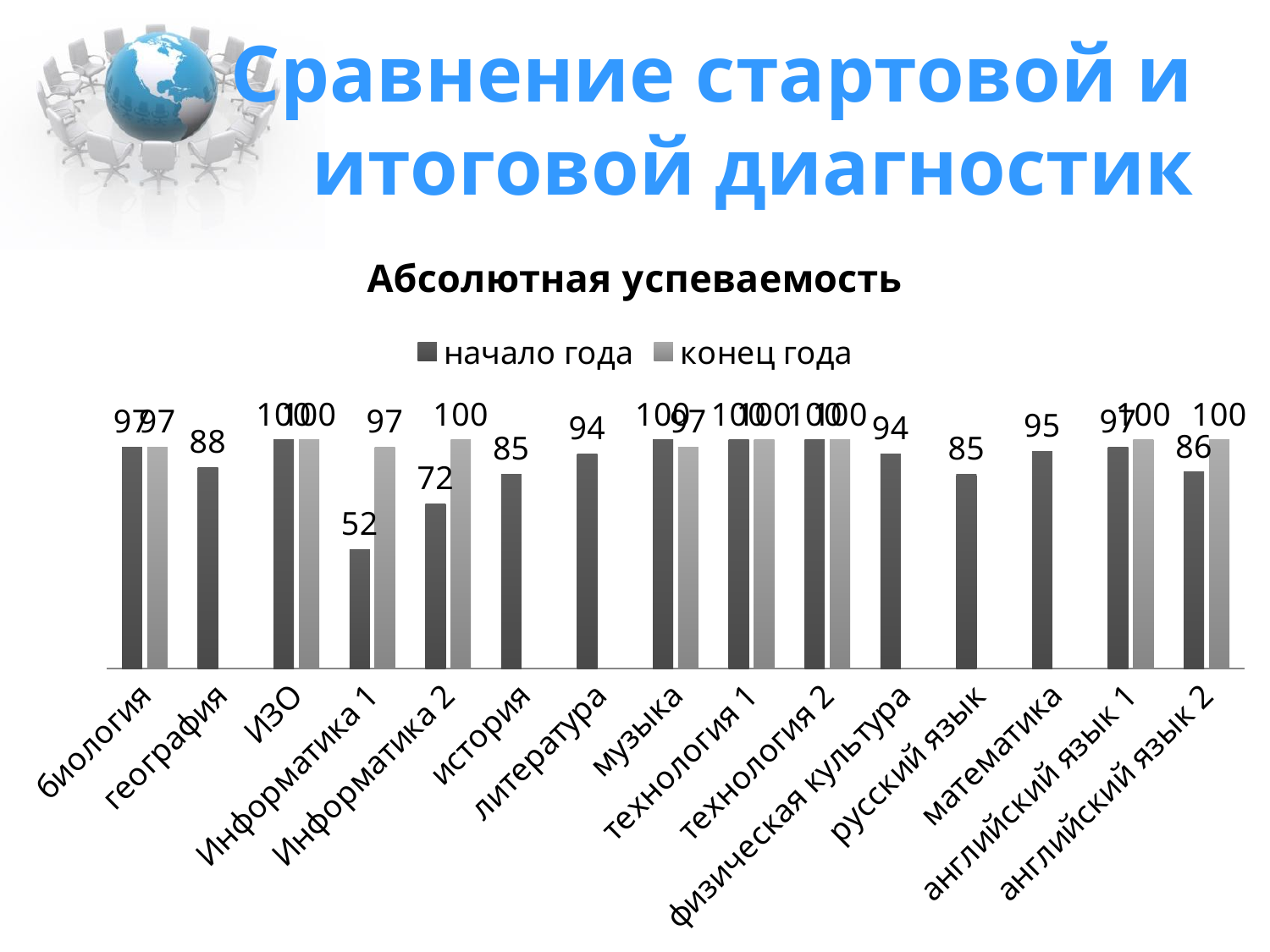
What is the value for Информатика 2 in the конец года series? 100 How many series does the legend list? 2 Which is larger for музыка: the начало года value or the конец года value? начало года What is the value for Информатика 1 in the начало года series? 52 What kind of chart is shown on the slide? bar chart What is the difference between the конец года and начало года values for Информатика 1? 45 What is the value for английский язык 2 in the начало года series? 86 How many categories are shown on the x axis? 15 Which category has the lowest value in the начало года series? Информатика 1 What is the value for география in the начало года series? 88 What is the difference between the конец года and начало года values for Информатика 2? 28 What is the title of the chart? Абсолютная успеваемость